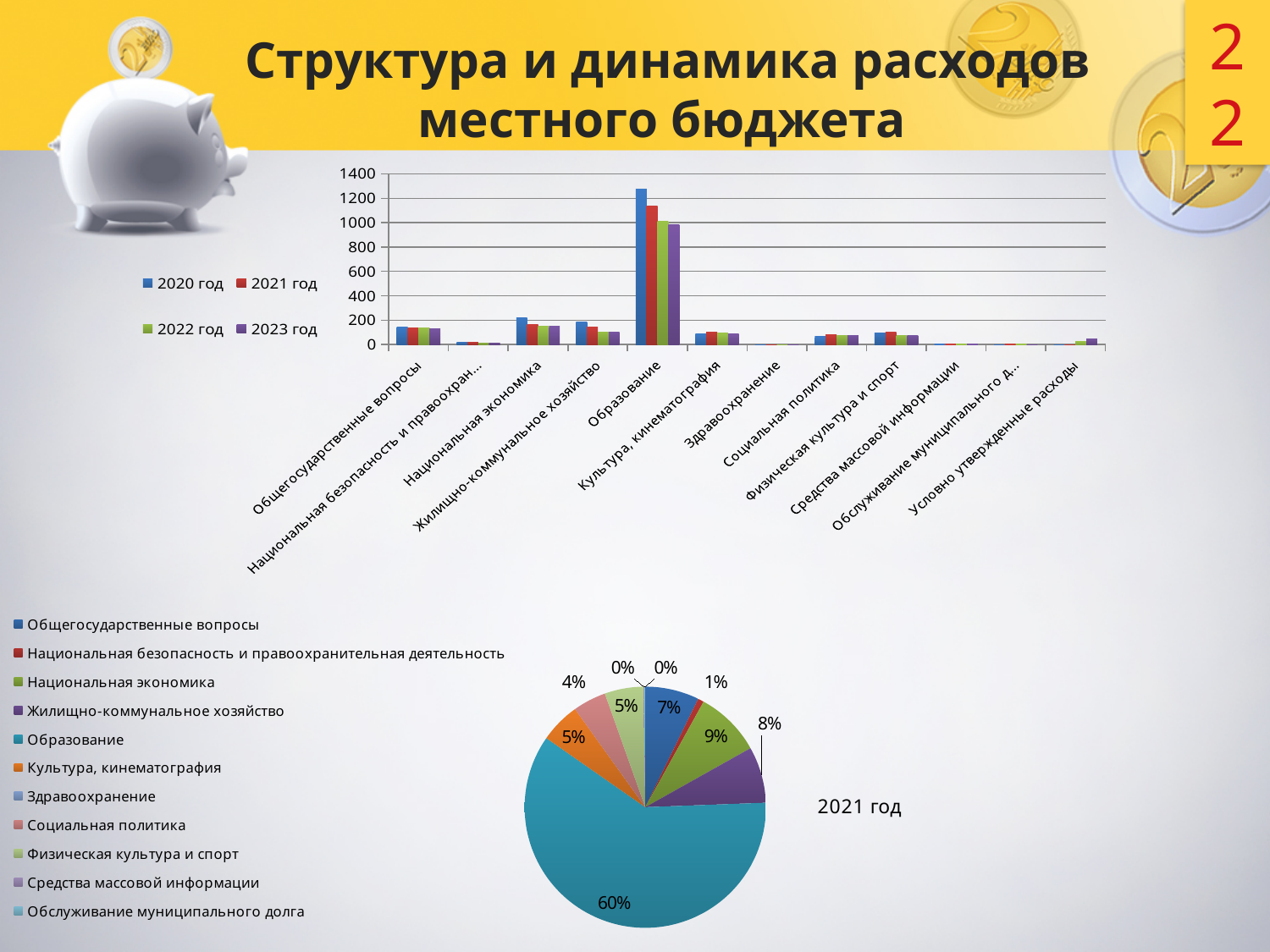
In the bottom pie chart, what share does Образование have? 60% Which year does the bottom pie chart represent? 2021 год In the bottom pie chart, which category has the largest slice? Образование What kind of chart is the bottom chart on the slide? pie chart In the top bar chart, how many categories are shown on the x axis? 12 In the top bar chart, how many series does the legend list? 4 In the top bar chart, which is larger for Образование: the 2020 год value or the 2023 год value? 2020 год In the bottom pie chart, what share does Национальная экономика have? 9% In the top bar chart, is the 2020 год value for Образование greater or less than 1200? greater In the top bar chart, which category has the highest value for 2020 год? Образование What kind of chart is the top chart on the slide? bar chart In the top bar chart, is the 2023 год value for Образование greater or less than 1200? less